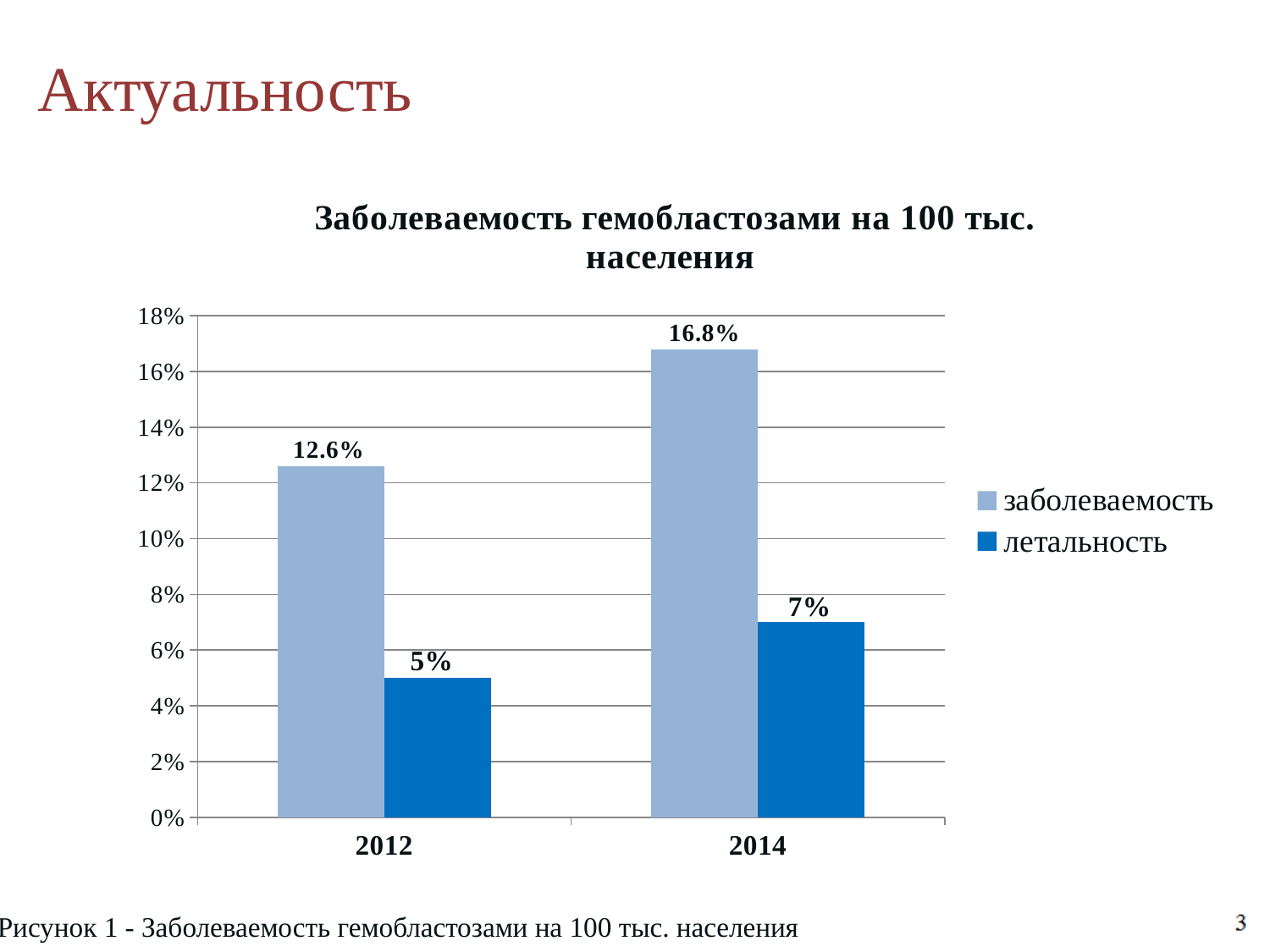
Which year has the lower value for летальность? 2012 What is the difference between заболеваемость in 2014 and in 2012? 4.2% What is the value for летальность in 2012? 5% Which year has the higher value for заболеваемость? 2014 How many years are shown on the x axis? 2 What is the value for летальность in 2014? 7% What is the value for заболеваемость in 2014? 16.8% Which is larger: заболеваемость in 2012 or летальность in 2014? заболеваемость in 2012 How many series does the legend list? 2 What is the difference between летальность in 2014 and in 2012? 2% What is the value for заболеваемость in 2012? 12.6% What kind of chart is shown on the slide? bar chart